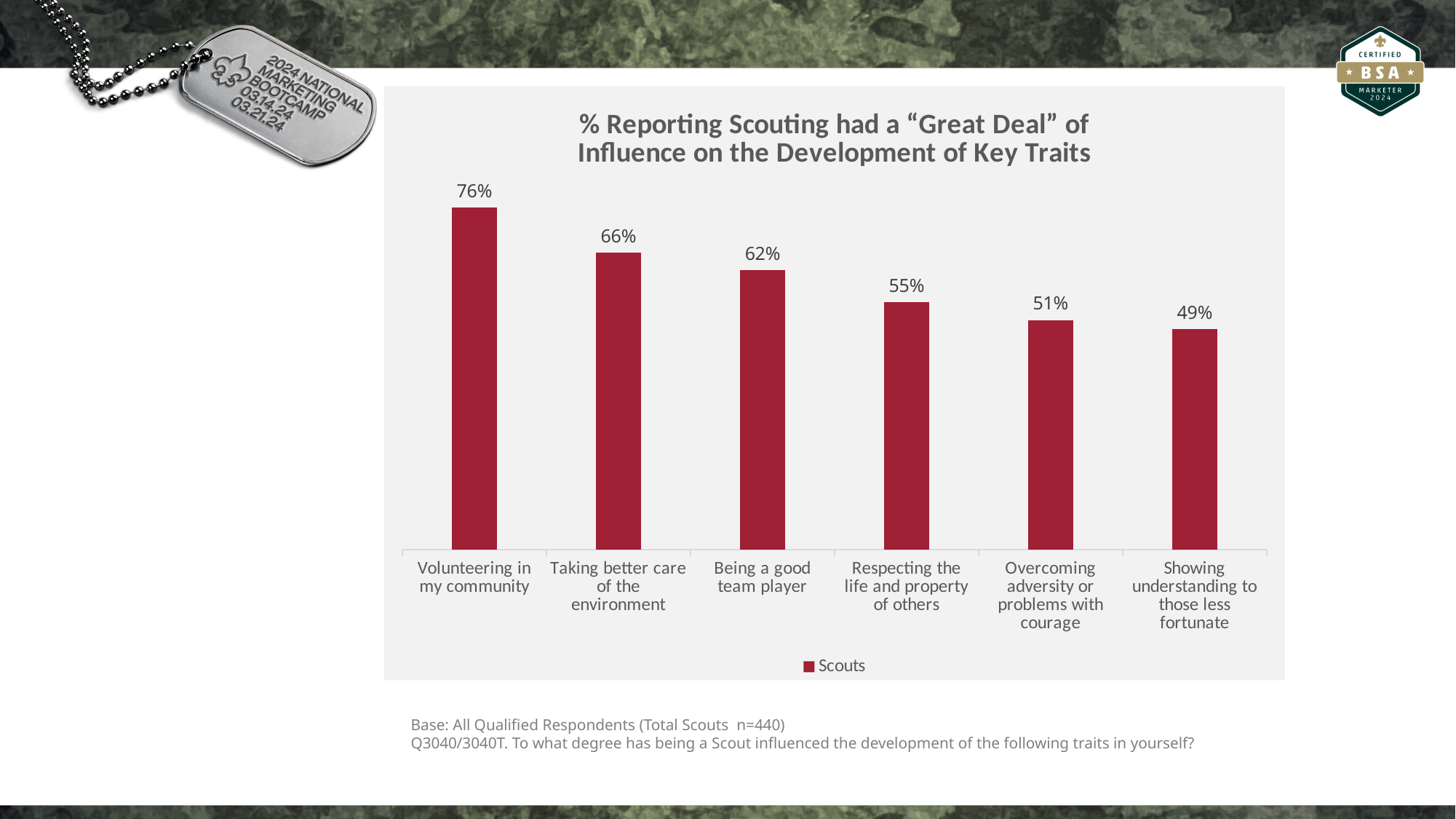
Which trait has the lowest percentage? Showing understanding to those less fortunate What is the difference between the values for Volunteering in my community and Showing understanding to those less fortunate? 27% How many traits are shown in the chart? 6 What is the difference between the values for Being a good team player and Respecting the life and property of others? 7% Which trait has the highest percentage? Volunteering in my community What kind of chart is shown? Bar chart What percentage of Scouts reported Scouting had a "Great Deal" of influence on Volunteering in my community? 76% What is the value for Taking better care of the environment? 66% Do the values rise or fall from left to right across the chart? Fall Which is larger: the value for Taking better care of the environment or Being a good team player? Taking better care of the environment How many series does the legend list? 1 What is the value for Overcoming adversity or problems with courage? 51%